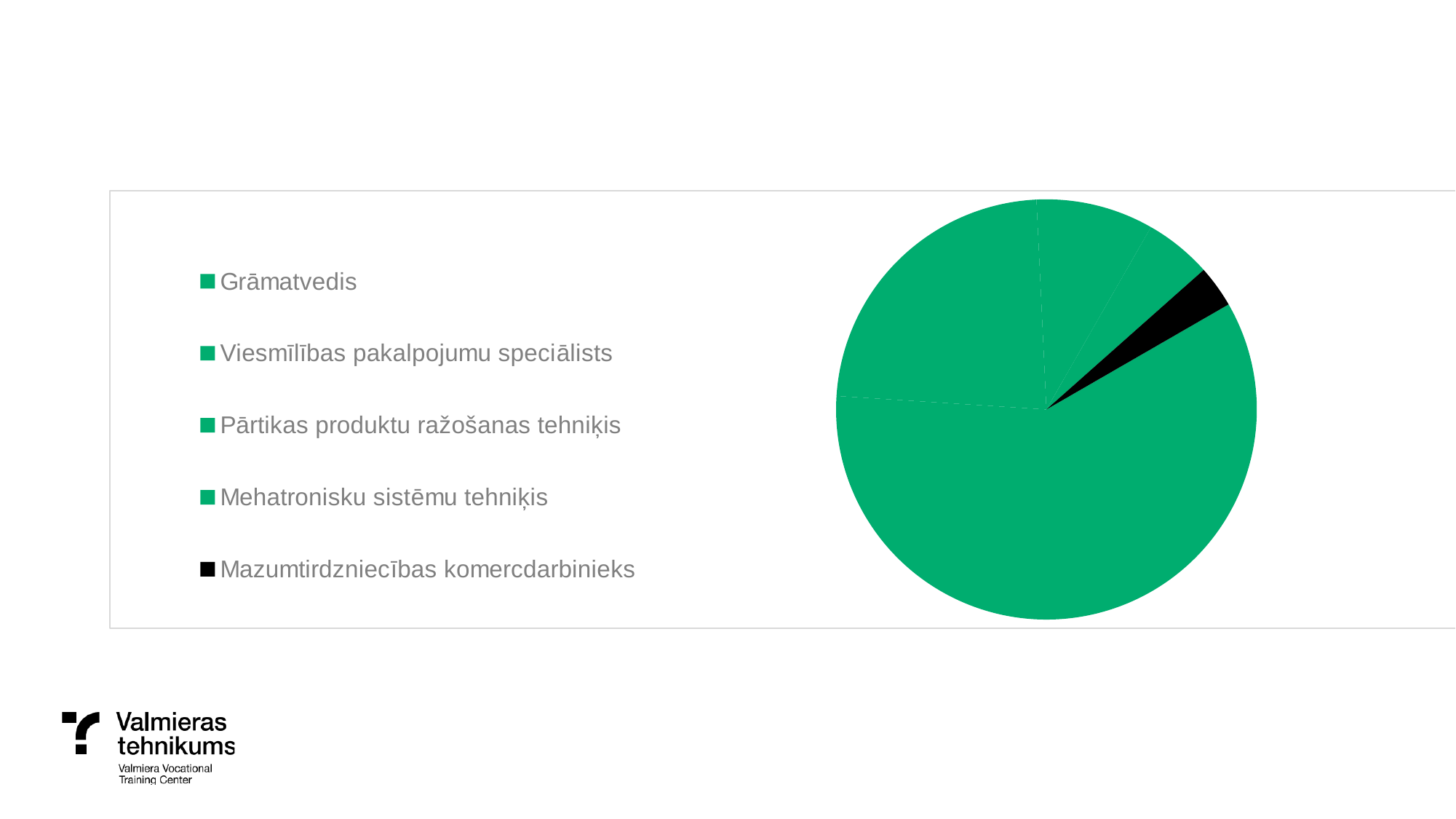
What kind of chart is shown on the slide? pie chart Is the black slice (Mazumtirdzniecības komercdarbinieks) the largest slice of the pie chart? No Which category in the pie chart is shown in black? Mazumtirdzniecības komercdarbinieks How many categories does the legend of the pie chart list? 5 What colour are the slices for all categories other than Mazumtirdzniecības komercdarbinieks in the pie chart? green